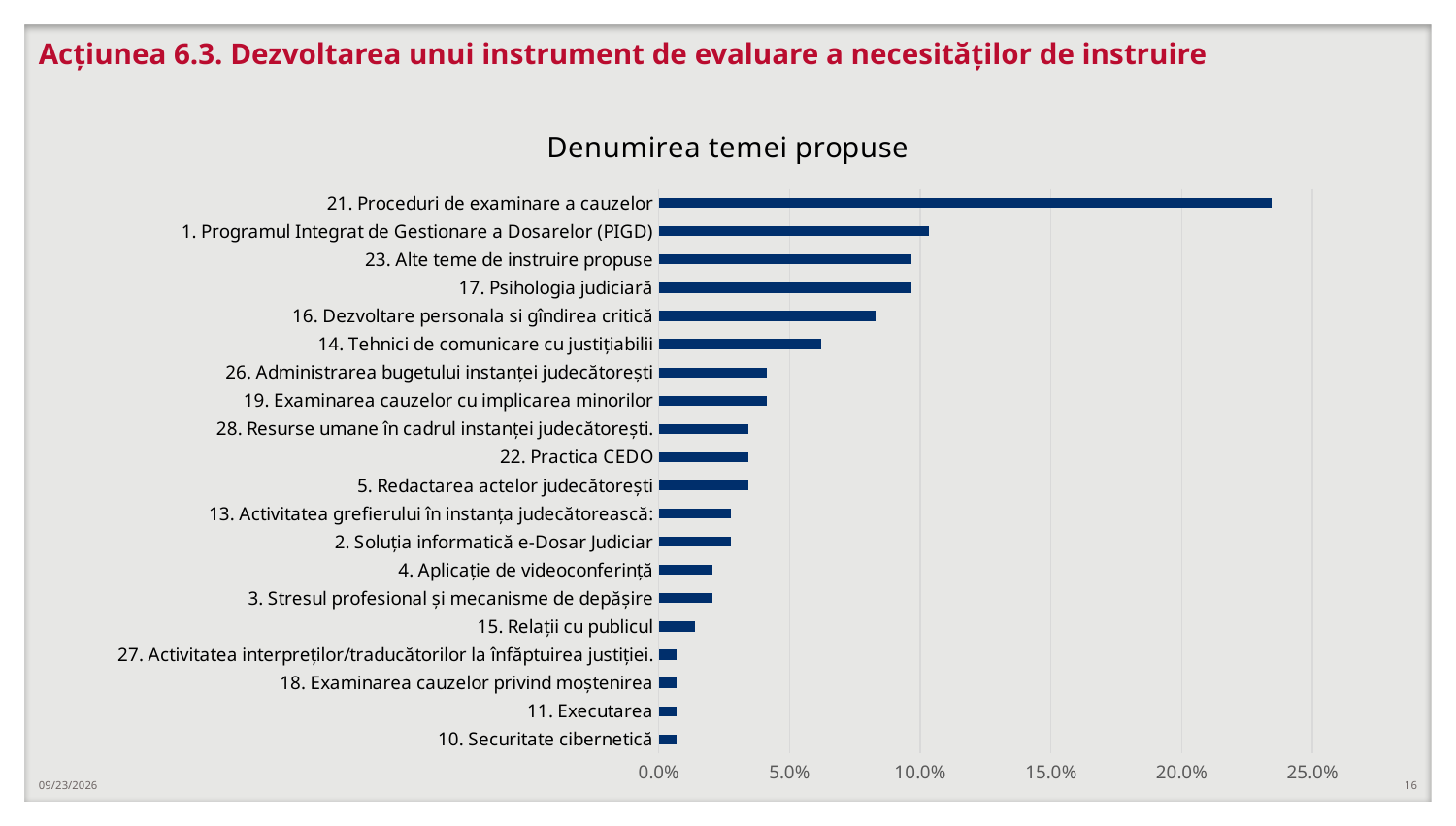
Is the value for '26. Administrarea bugetului instanței judecătorești' greater or less than 5.0%? less Is the value for '16. Dezvoltare personala si gîndirea critică' greater or less than 10.0%? less What is the title of the chart? Denumirea temei propuse What kind of chart is shown on the slide? bar chart Is the value for '14. Tehnici de comunicare cu justițiabilii' greater or less than 5.0%? greater How many categories (proposed topics) are plotted in the chart? 20 Which category has the highest value? 21. Proceduri de examinare a cauzelor Which has a larger value: '21. Proceduri de examinare a cauzelor' or '1. Programul Integrat de Gestionare a Dosarelor (PIGD)'? 21. Proceduri de examinare a cauzelor What is the highest value shown on the horizontal axis? 25.0% Which has a larger value: '16. Dezvoltare personala si gîndirea critică' or '14. Tehnici de comunicare cu justițiabilii'? 16. Dezvoltare personala si gîndirea critică